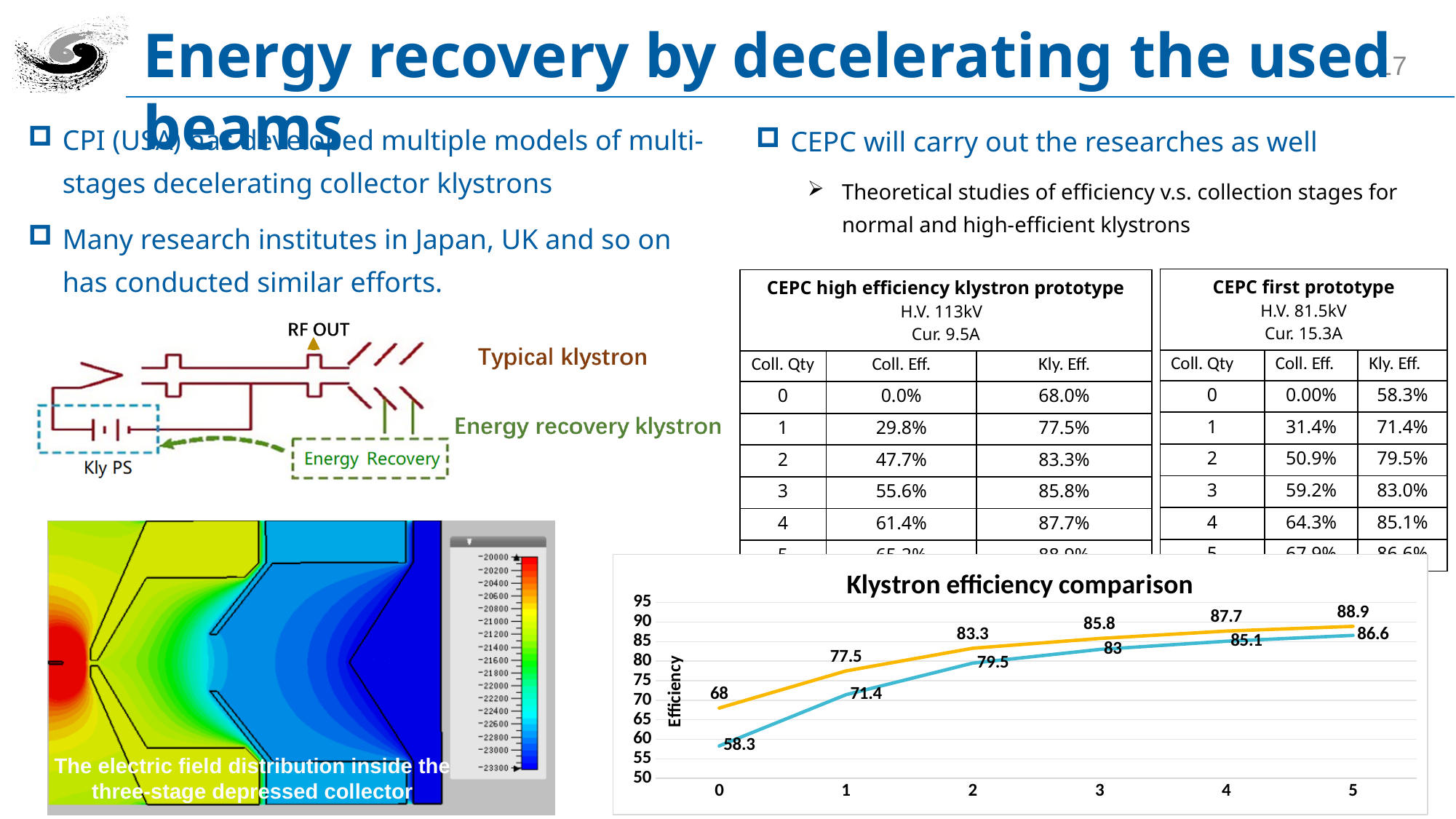
In the 'Klystron efficiency comparison' chart, which line has the higher value at x = 1, the orange or the blue? orange In the 'Klystron efficiency comparison' chart, at which x value is the blue line lowest? 0 In the 'Klystron efficiency comparison' chart, what is the value of the orange line at x = 2? 83.3 In the 'Klystron efficiency comparison' chart, what is the difference between the orange and blue lines at x = 0? 9.7 In the 'Klystron efficiency comparison' chart, what is the value of the blue line at x = 4? 85.1 What is the title of the chart at the bottom right of the slide? Klystron efficiency comparison What kind of chart is the 'Klystron efficiency comparison' chart? line chart In the 'Klystron efficiency comparison' chart, is the value of the blue line at x = 2 greater or less than 80? less In the 'Klystron efficiency comparison' chart, at which x value does the orange line reach its highest value? 5 In the 'Klystron efficiency comparison' chart, what is the value of the blue line at x = 0? 58.3 In the 'Klystron efficiency comparison' chart, how many data points does each line have? 6 In the 'Klystron efficiency comparison' chart, do the values rise or fall as x increases from 0 to 5? rise